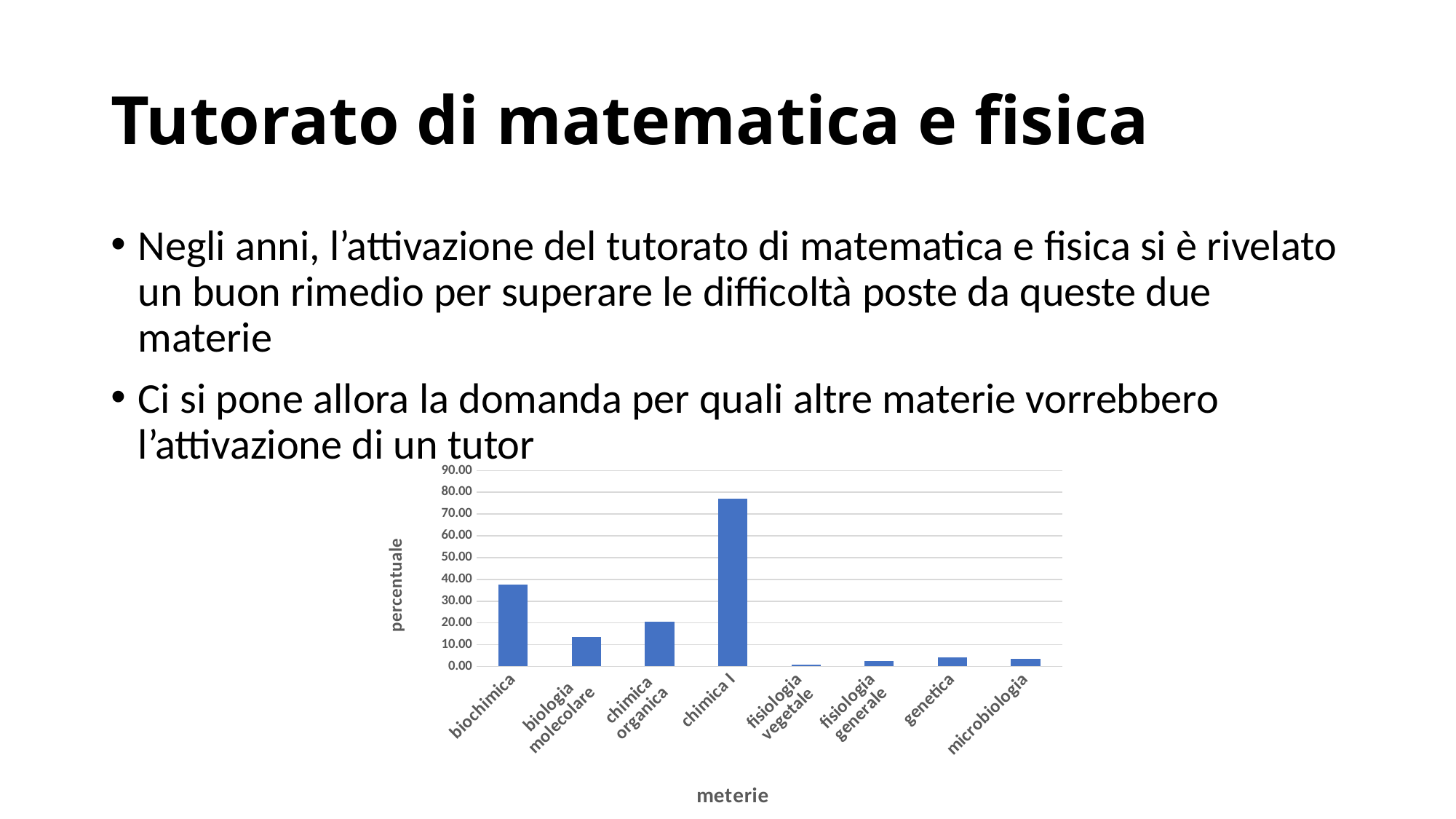
Which category has the lowest value in the chart? fisiologia vegetale Is the value for biochimica greater or less than 30.00? greater Is the value for chimica organica greater or less than 10.00? greater What kind of chart is shown on the slide? bar chart Is the value for biologia molecolare greater or less than 20.00? less Which has a larger value, biochimica or chimica organica? biochimica Which category has the highest value in the chart? chimica I How many categories (materie) are shown on the x axis of the chart? 8 What is the label of the vertical axis of the chart? percentuale Which has a larger value, biologia molecolare or microbiologia? biologia molecolare